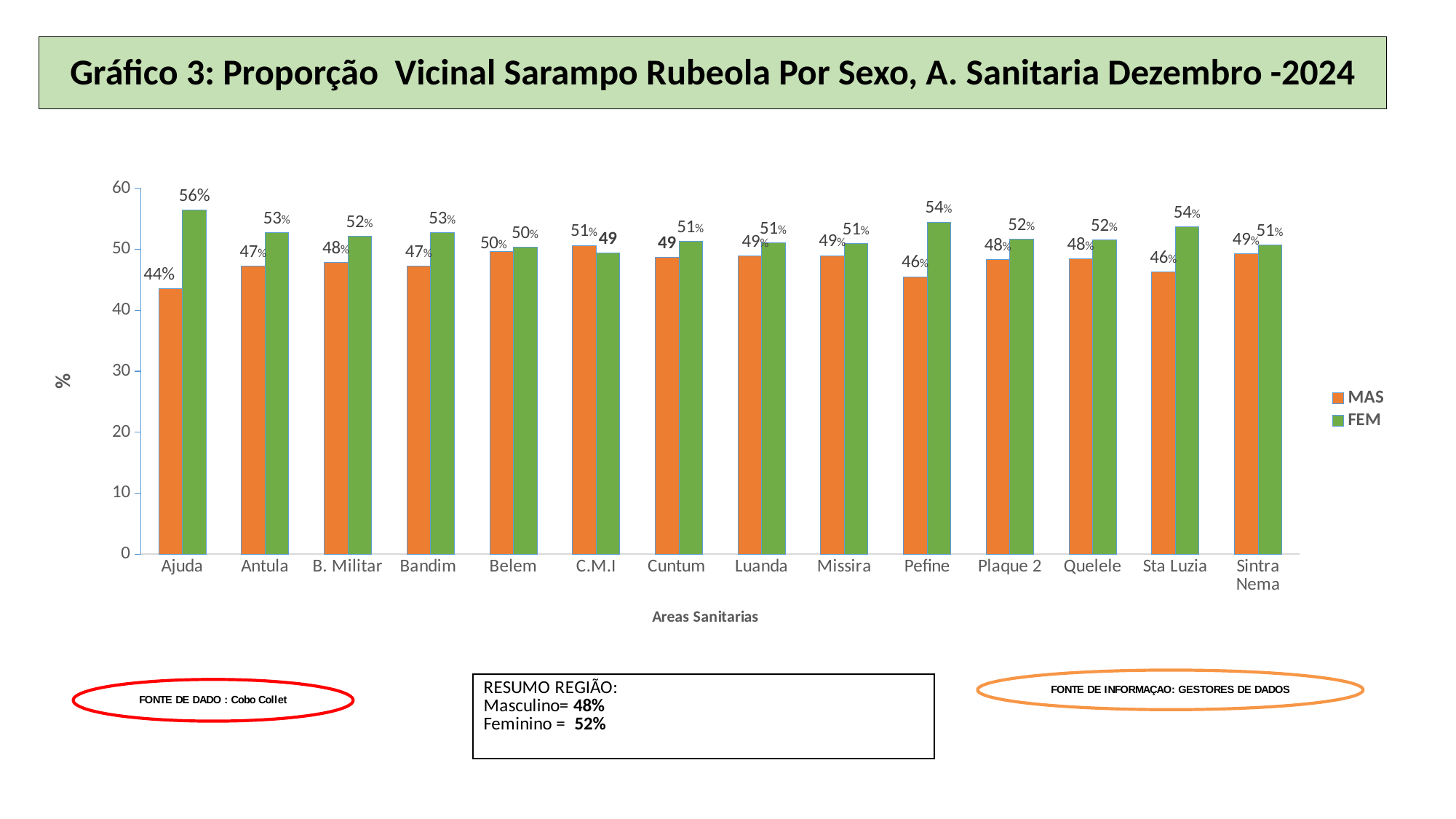
Is the MAS value for Ajuda greater or less than 40? greater What kind of chart is shown on the slide? bar chart Which area has the highest FEM value? Ajuda What is the MAS value for C.M.I? 51% For Pefine, which is larger, the MAS value or the FEM value? FEM What is the MAS value for Ajuda? 44% What is the FEM value for Pefine? 54% How many areas (categories) are shown on the x axis? 14 For C.M.I, which is larger, the MAS value or the FEM value? MAS Which area has the lowest MAS value? Ajuda What is the difference between the FEM and MAS values for Ajuda? 12% How many series does the legend list? 2